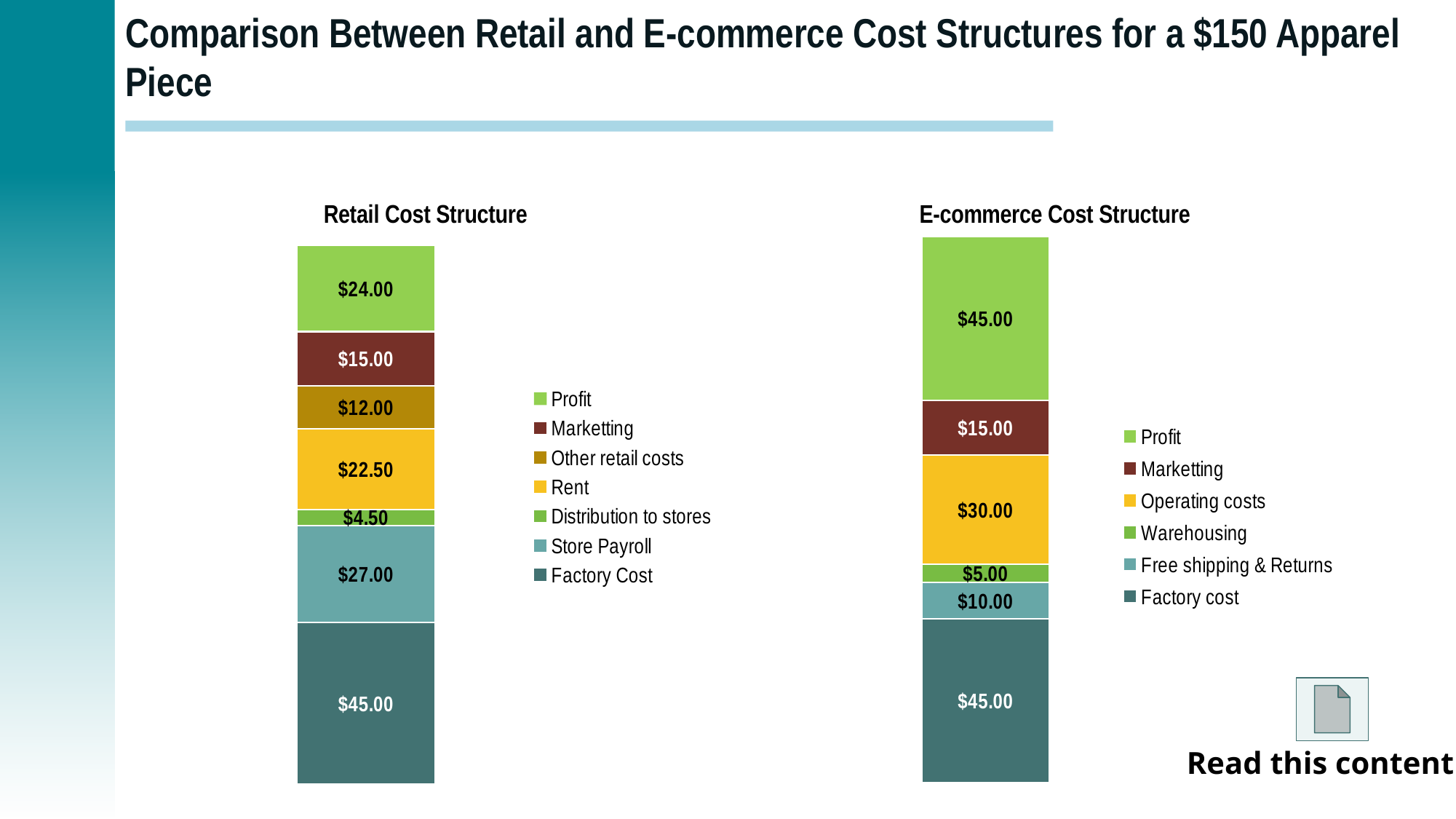
In the Retail Cost Structure chart, which is larger, Rent or Store Payroll? Store Payroll In the Retail Cost Structure chart, what is the value for Rent? $22.50 In the Retail Cost Structure chart, what is the value for Store Payroll? $27.00 In the Retail Cost Structure chart, which segment has the smallest value? Distribution to stores In the Retail Cost Structure chart, which segment has the largest value? Factory Cost What is the difference between Profit in the E-commerce Cost Structure chart and Profit in the Retail Cost Structure chart? $21.00 In the E-commerce Cost Structure chart, what is the value for Free shipping & Returns? $10.00 How many series does the legend of the Retail Cost Structure chart list? 7 In the E-commerce Cost Structure chart, which segment has the smallest value? Warehousing What is the total of the stacked bar in the E-commerce Cost Structure chart? $150.00 In the E-commerce Cost Structure chart, what is the value for Operating costs? $30.00 What type of chart is the E-commerce Cost Structure chart? Stacked bar chart